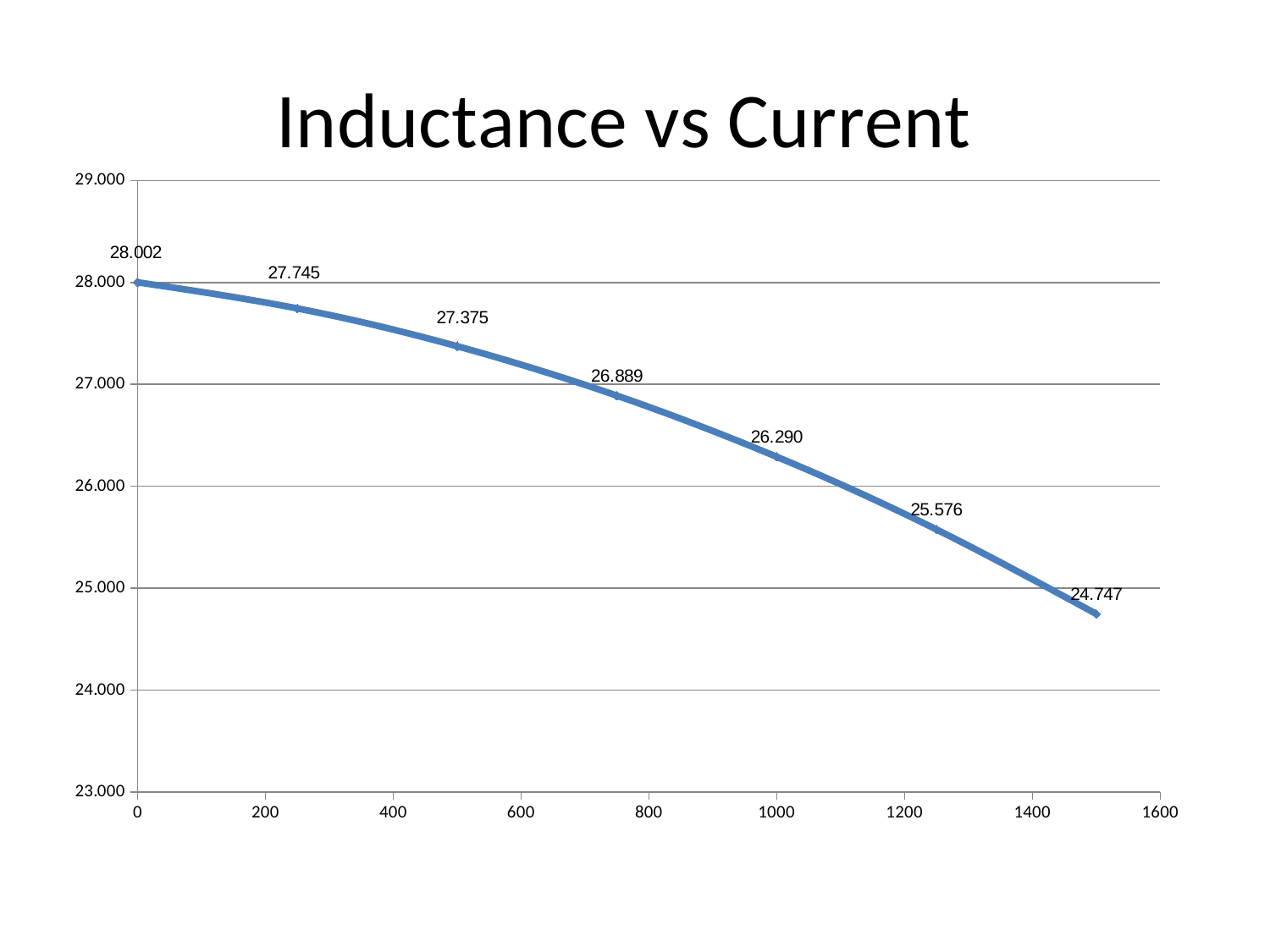
What type of chart is shown on the slide? line chart What is the value of the last (rightmost) data point on the curve? 24.747 What is the value of the second data point on the curve? 27.745 What is the difference between the first data point (28.002) and the last data point (24.747)? 3.255 Which data point has the highest inductance value? 28.002 (at current 0) Which data point has the lowest inductance value? 24.747 (the rightmost point) What is the inductance value at a current of 0? 28.002 What is the inductance value at a current of 1000? 26.290 Is the inductance value at a current of 1000 greater or less than 27.000? less What is the title of the chart? Inductance vs Current How many labelled data points are plotted on the curve? 7 Do the inductance values rise or fall as current increases along the x axis? fall